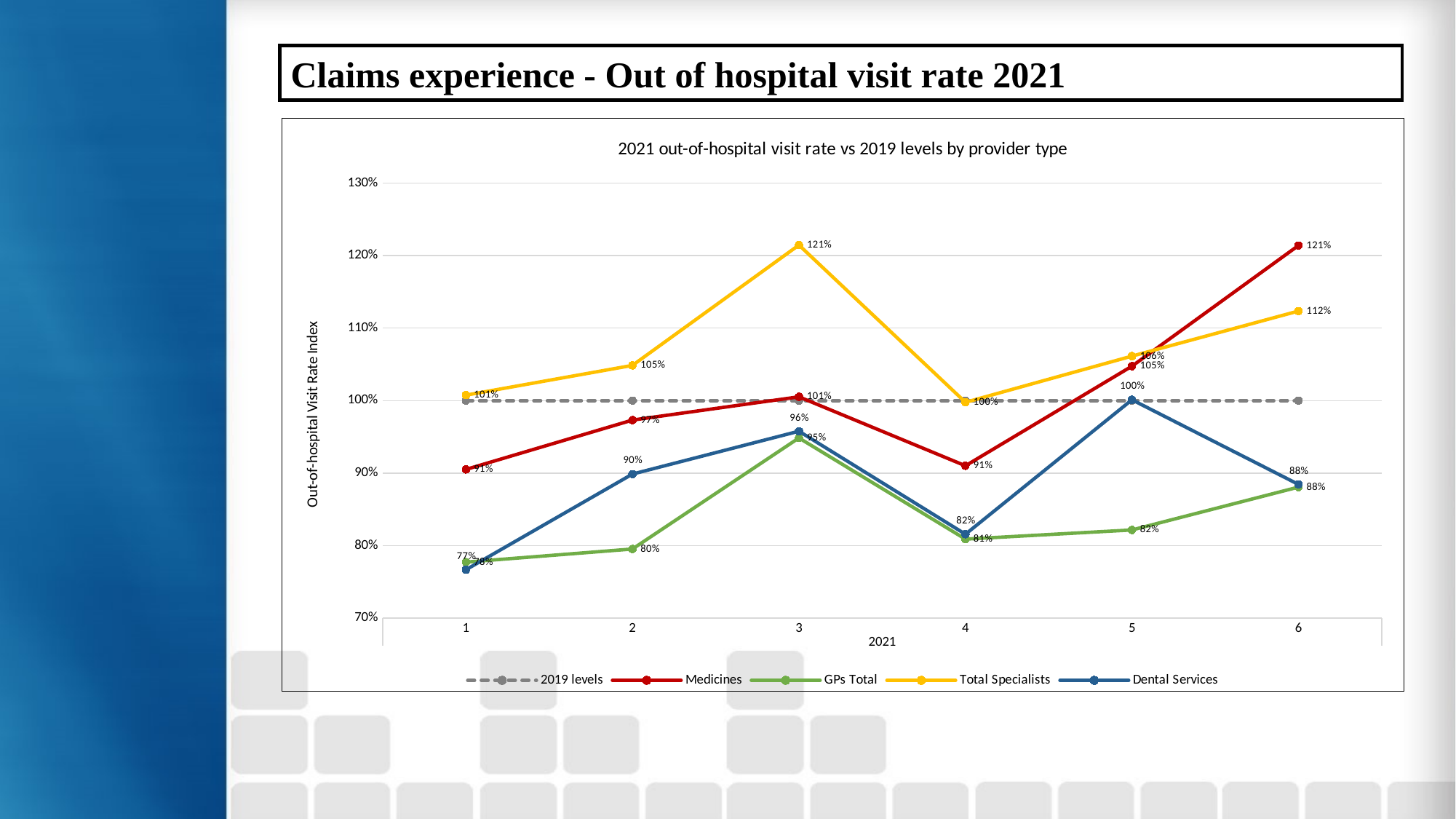
What type of chart is shown on the slide? Line chart At which month does Total Specialists reach its highest value? 3 How many points are plotted along the x axis for each series? 6 What is the value for Medicines at month 6? 121% What is the value for GPs Total at month 1? 78% Which is larger at month 6, Medicines or Total Specialists? Medicines What is the title of the chart? 2021 out-of-hospital visit rate vs 2019 levels by provider type How many series does the legend list? 5 What is the difference between Total Specialists and GPs Total at month 3? 26% What is the value for Dental Services at month 5? 100% What is the value for Total Specialists at month 3? 121%